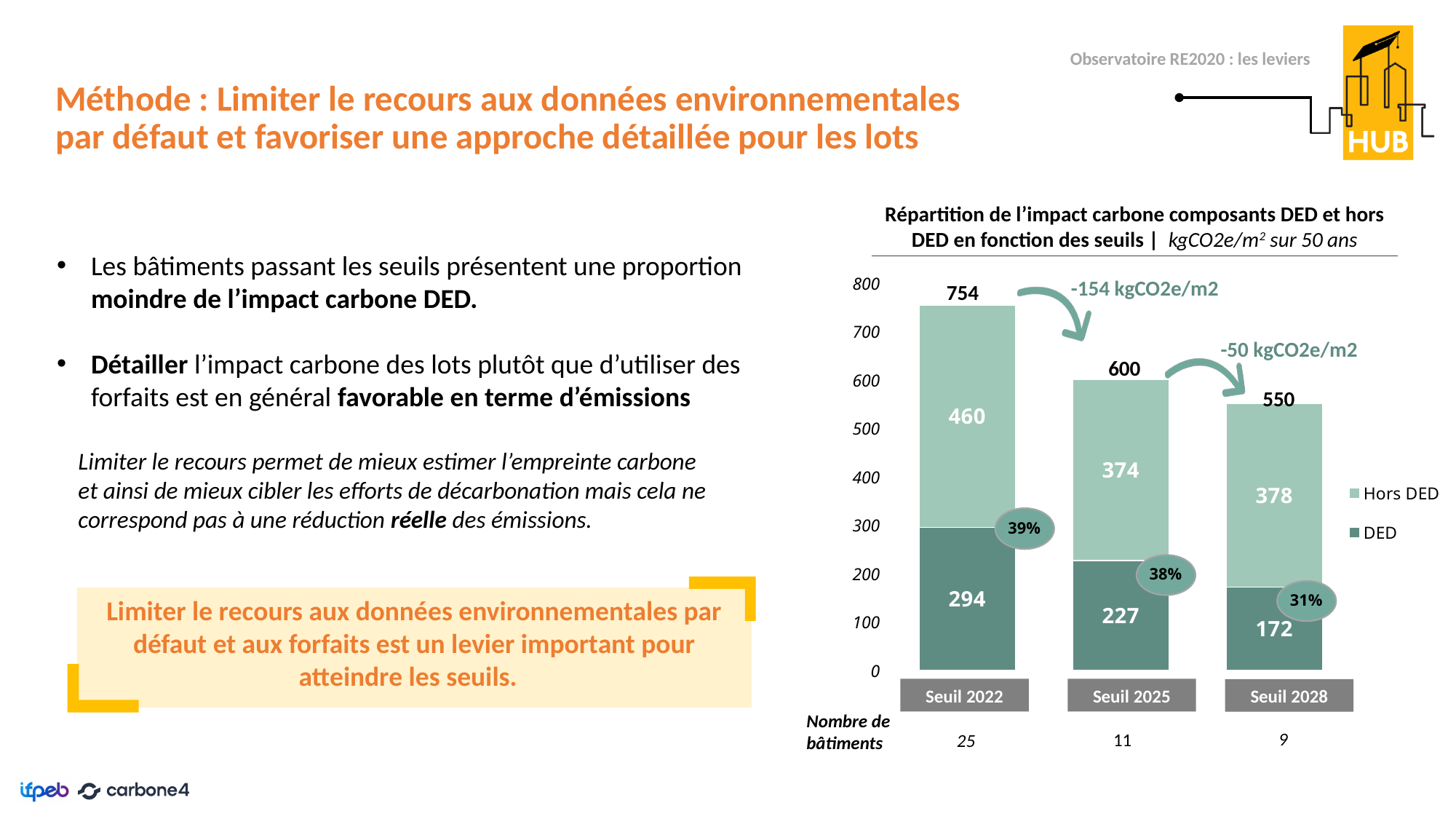
What is the difference between the DED values for Seuil 2022 and Seuil 2025? 67 Which category has the highest total stacked bar? Seuil 2022 How many categories are shown on the x axis? 3 Do the total values rise or fall from Seuil 2022 to Seuil 2028? Fall Which is larger, the Hors DED value for Seuil 2025 or for Seuil 2028? Seuil 2028 What is the DED value for Seuil 2022? 294 What is the total of the stacked bar for Seuil 2025? 600 Which category has the lowest DED value? Seuil 2028 How many series does the legend list? 2 What is the Hors DED value for Seuil 2028? 378 What percentage is shown in the bubble on the Seuil 2028 bar? 31% What kind of chart is shown on the slide? Stacked bar chart